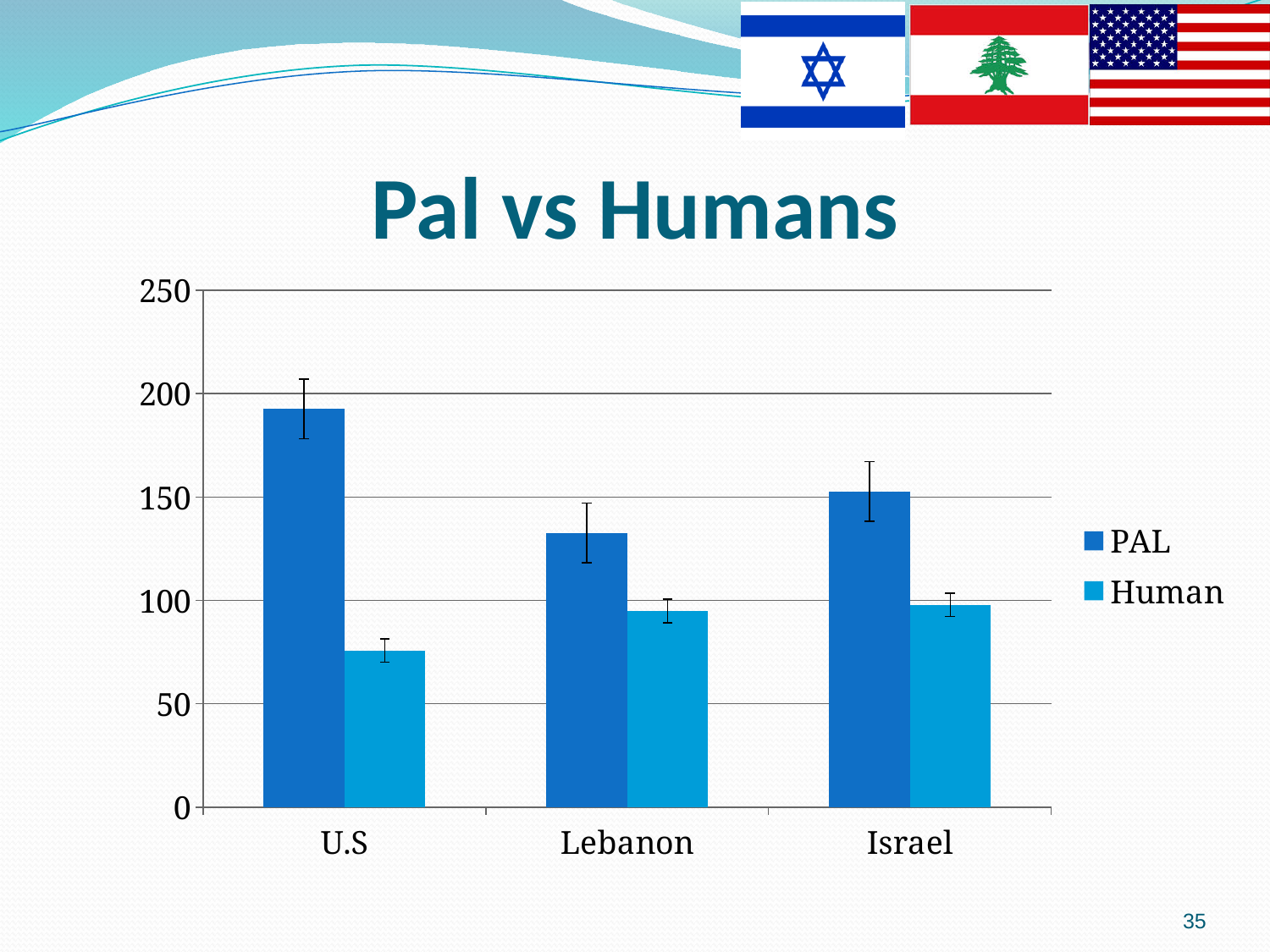
How many categories are shown on the x axis? 3 Which is larger, the PAL value for Israel or the PAL value for Lebanon? Israel Is the PAL value for Lebanon greater or less than 150? less How many series does the legend list? 2 Which category has the lowest PAL value? Lebanon Which series is shown in the darker blue bars? PAL Is the PAL value for U.S greater or less than 150? greater Which category has the lowest Human value? U.S Which category has the highest PAL value? U.S Is the Human value for U.S greater or less than 100? less What is the title of the chart? Pal vs Humans What kind of chart is shown on the slide? bar chart